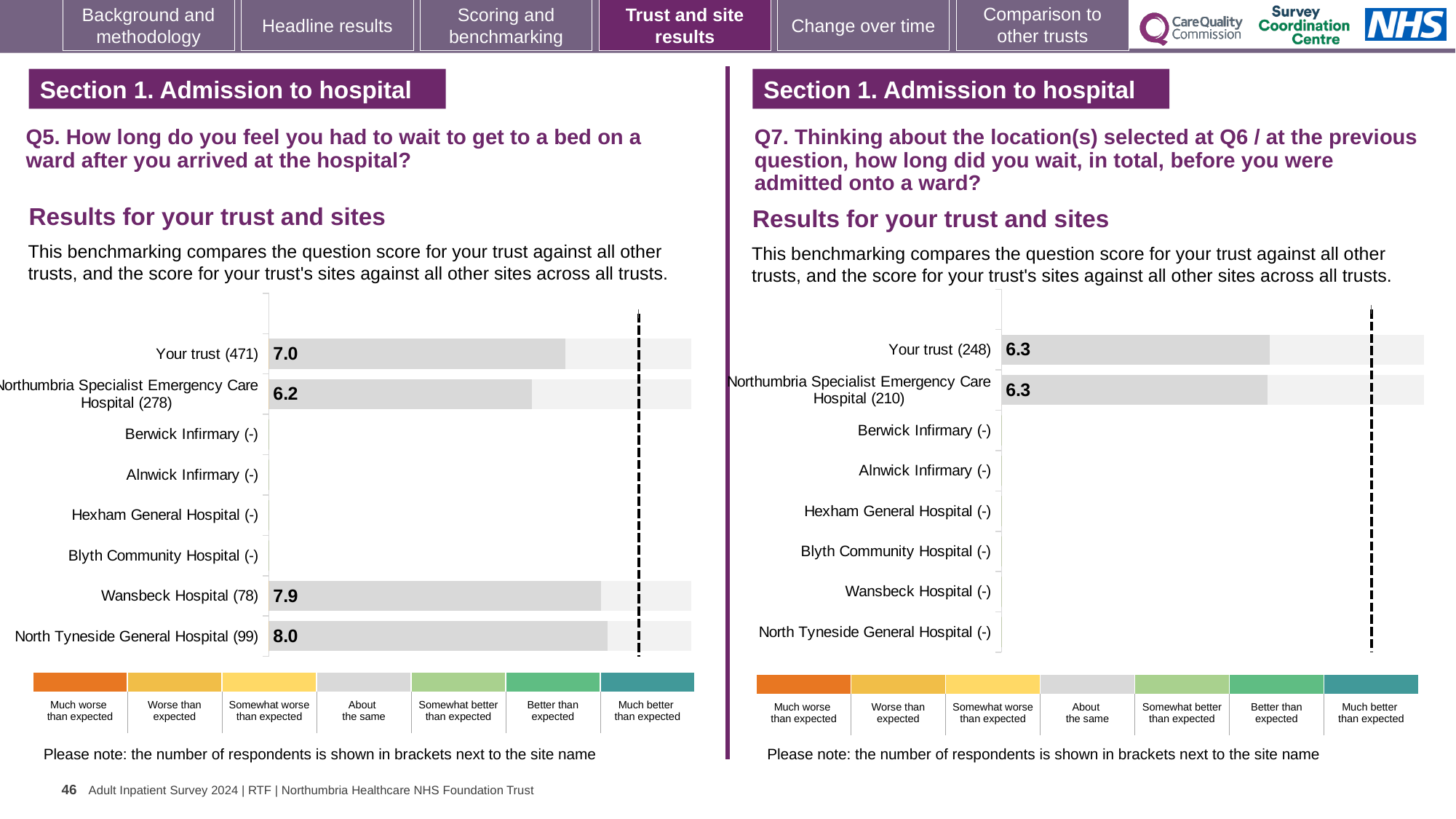
In the Q5 chart on the left, what is the score for Wansbeck Hospital? 7.9 In the Q5 chart on the left, what is the score for Your trust? 7.0 In the Q5 chart on the left, which site has the highest score shown? North Tyneside General Hospital In the Q5 chart on the left, what is the score for North Tyneside General Hospital? 8.0 In the Q7 chart on the right, what is the score for Northumbria Specialist Emergency Care Hospital? 6.3 In the Q5 chart on the left, what is the difference between the scores for North Tyneside General Hospital and Northumbria Specialist Emergency Care Hospital? 1.8 In the Q7 chart on the right, what is the score for Your trust? 6.3 In the Q7 chart on the right, how many respondents are shown for Your trust? 248 In the Q5 chart on the left, which site has the lowest score shown? Northumbria Specialist Emergency Care Hospital In the Q5 chart on the left, how many site rows (excluding Your trust) are listed? 7 In the Q5 chart on the left, which has a higher score: Your trust or Wansbeck Hospital? Wansbeck Hospital What kind of chart is used on the left for Q5? Bar chart